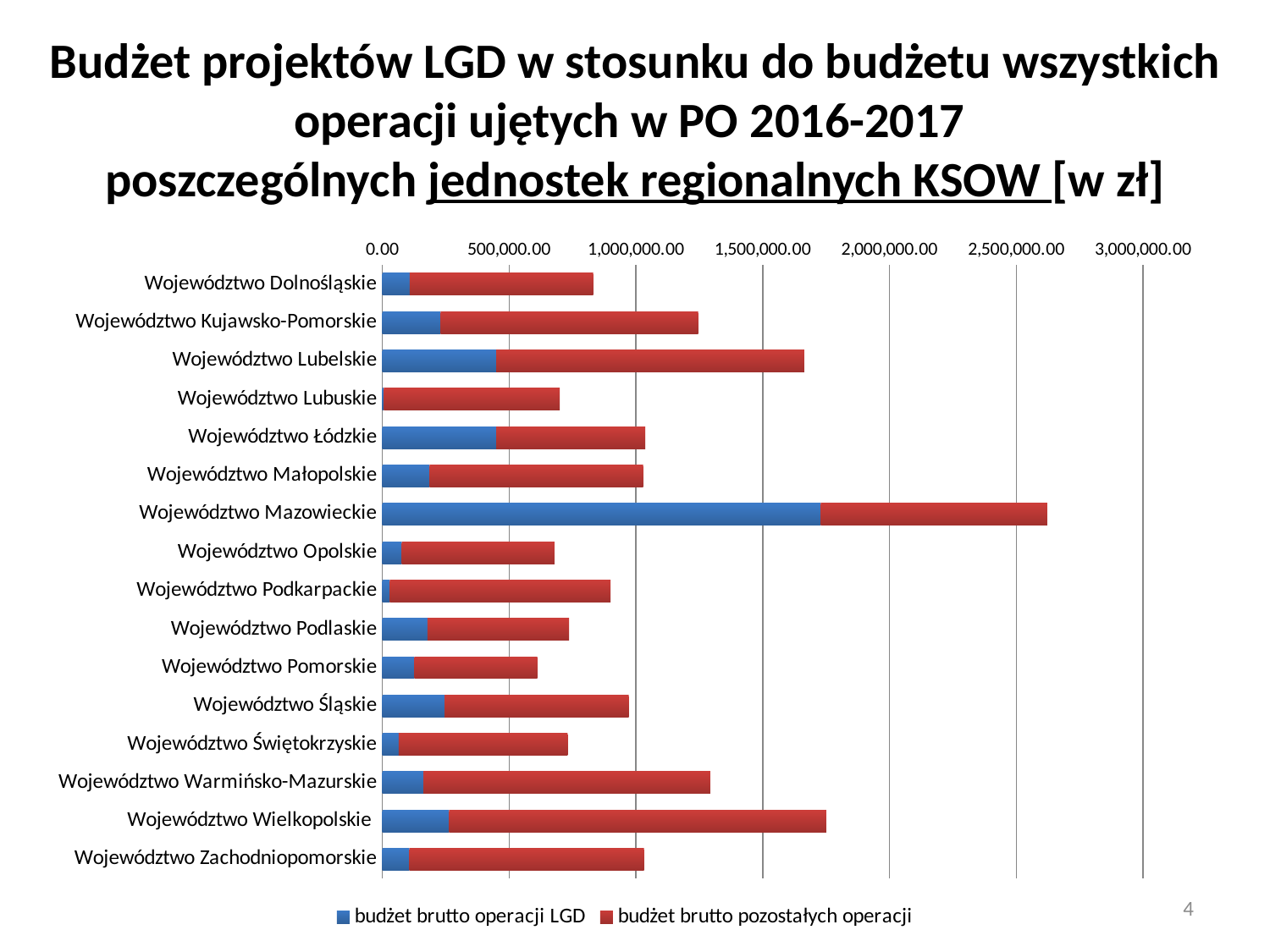
How many voivodeships (categories) are plotted on the chart? 16 Is the total bar for Województwo Mazowieckie greater or less than 2,500,000.00? greater Which has the larger total bar, Województwo Lubelskie or Województwo Łódzkie? Województwo Lubelskie What colour represents the series 'budżet brutto operacji LGD'? Blue Which voivodeship has the highest total budget bar? Województwo Mazowieckie Is the total bar for Województwo Dolnośląskie greater or less than 1,000,000.00? less Is the total bar for Województwo Lubelskie greater or less than 1,500,000.00? greater Which has the larger total bar, Województwo Śląskie or Województwo Podlaskie? Województwo Śląskie Which voivodeship has the largest 'budżet brutto operacji LGD' segment? Województwo Mazowieckie How many series does the legend list? 2 What kind of chart is shown on the slide? Stacked bar chart